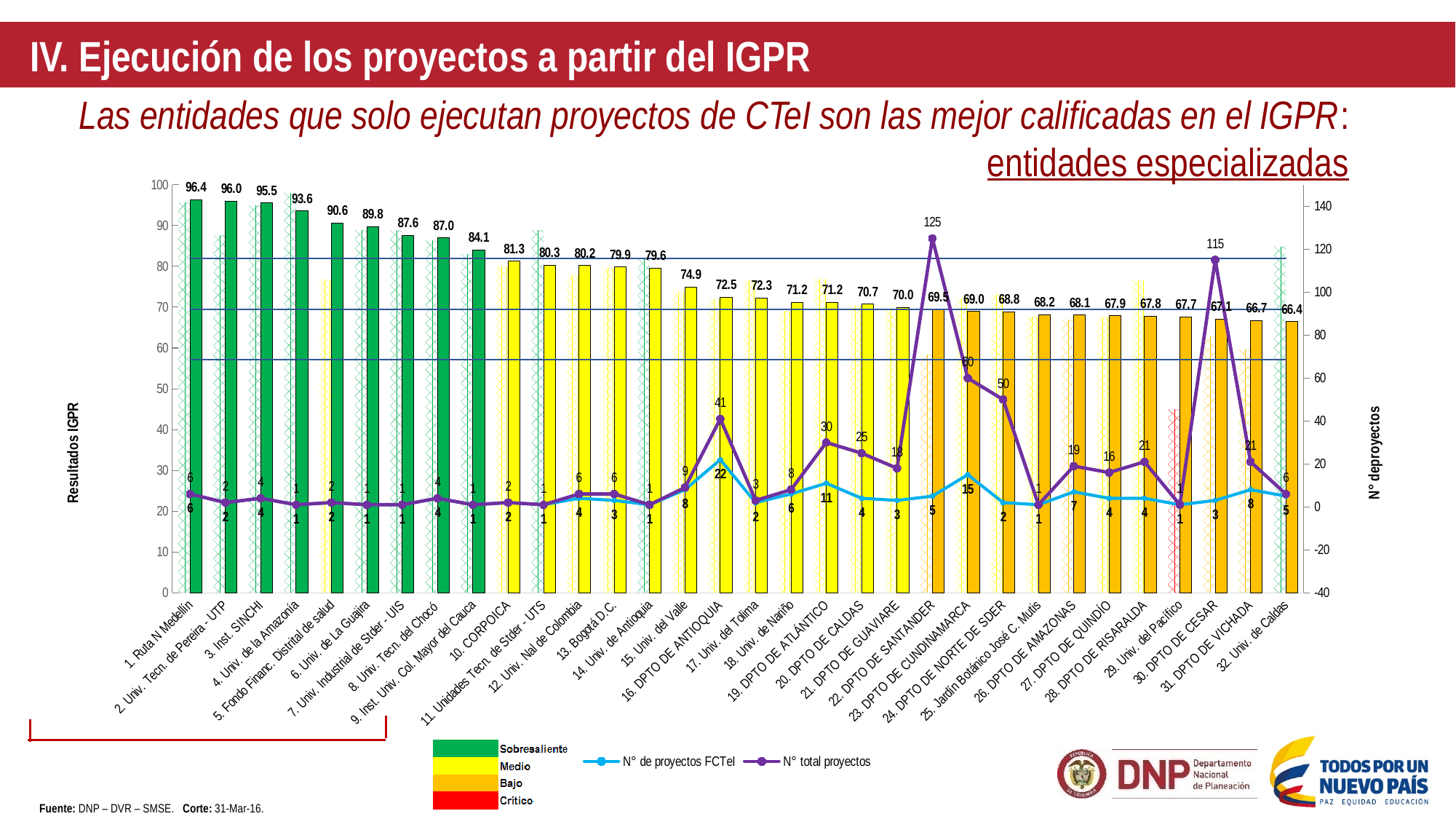
What kind of chart is used to show the Resultados IGPR values? Bar chart (combined with line series) Do the IGPR result bars rise or fall from left to right along the x axis? Fall What is the IGPR result (bar value) for 10. CORPOICA? 81.3 Is the IGPR result for 15. Univ. del Valle greater or less than 70? greater Which entity has the highest IGPR result bar? 1. Ruta N Medellín What is the IGPR result (bar value) for 1. Ruta N Medellín? 96.4 What is the N° total proyectos value shown for 22. DPTO DE SANTANDER? 125 How many entities are shown on the x axis of the chart? 32 How many line series does the legend list below the chart? 2 Which entity has the lowest IGPR result bar? 32. Univ. de Caldas Which has a higher N° total proyectos value: 22. DPTO DE SANTANDER or 30. DPTO DE CESAR? 22. DPTO DE SANTANDER What is the difference between the IGPR results of 1. Ruta N Medellín (96.4) and 32. Univ. de Caldas (66.4)? 30.0